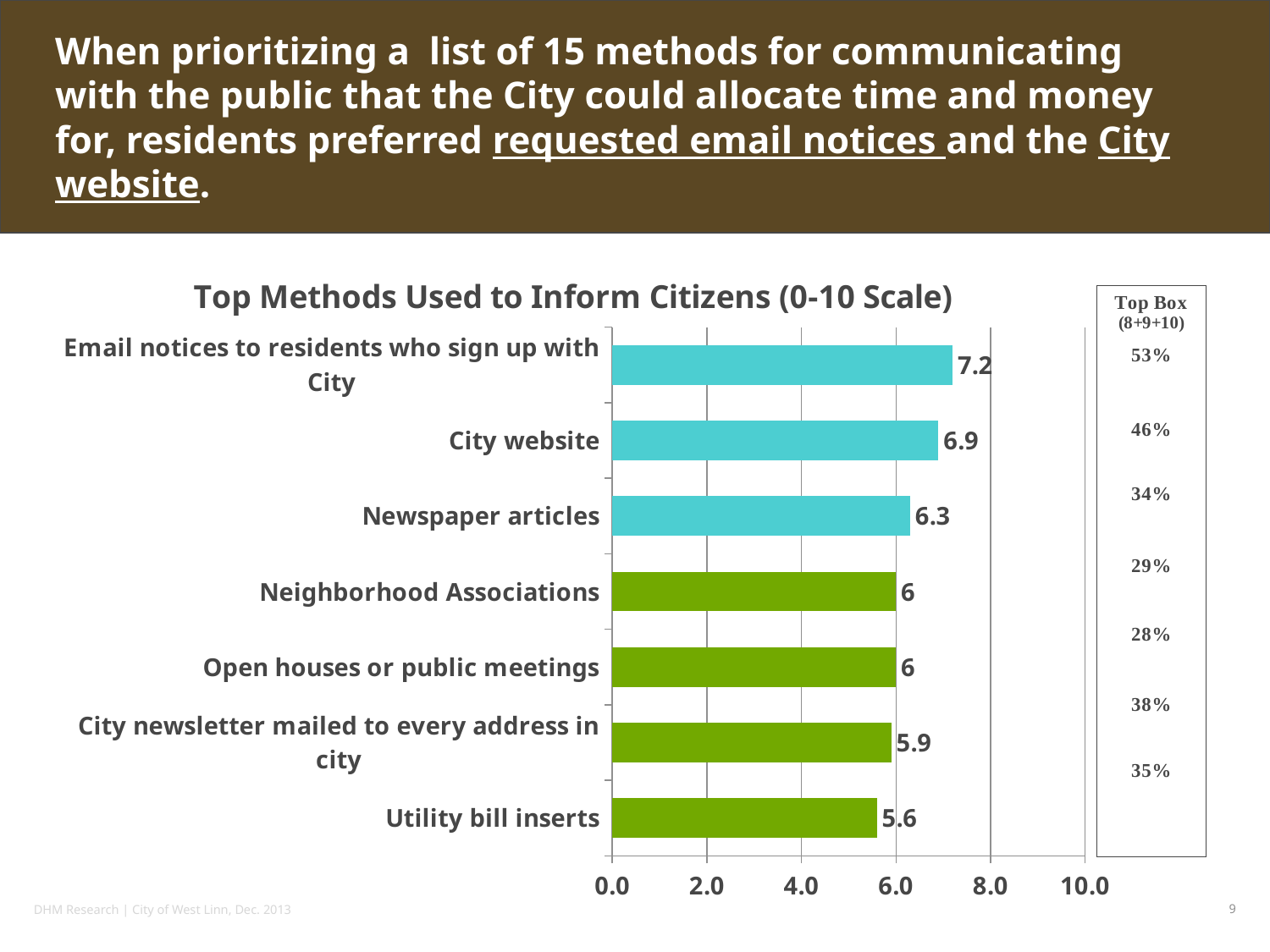
Which category has the lowest value? Utility bill inserts Which is larger, the value for Newspaper articles or the value for City newsletter mailed to every address in city? Newspaper articles What kind of chart is shown? Bar chart What is the value for Newspaper articles? 6.3 What is the difference between the values for Email notices to residents who sign up with City and City website? 0.3 What is the value for City website? 6.9 What is the value for Utility bill inserts? 5.6 How many categories are shown in the chart? 7 What is the Top Box (8+9+10) percentage shown for City website? 46% Which category has the highest value? Email notices to residents who sign up with City Is the value for Neighborhood Associations greater or less than 4.0? greater What is the title of the chart? Top Methods Used to Inform Citizens (0-10 Scale)